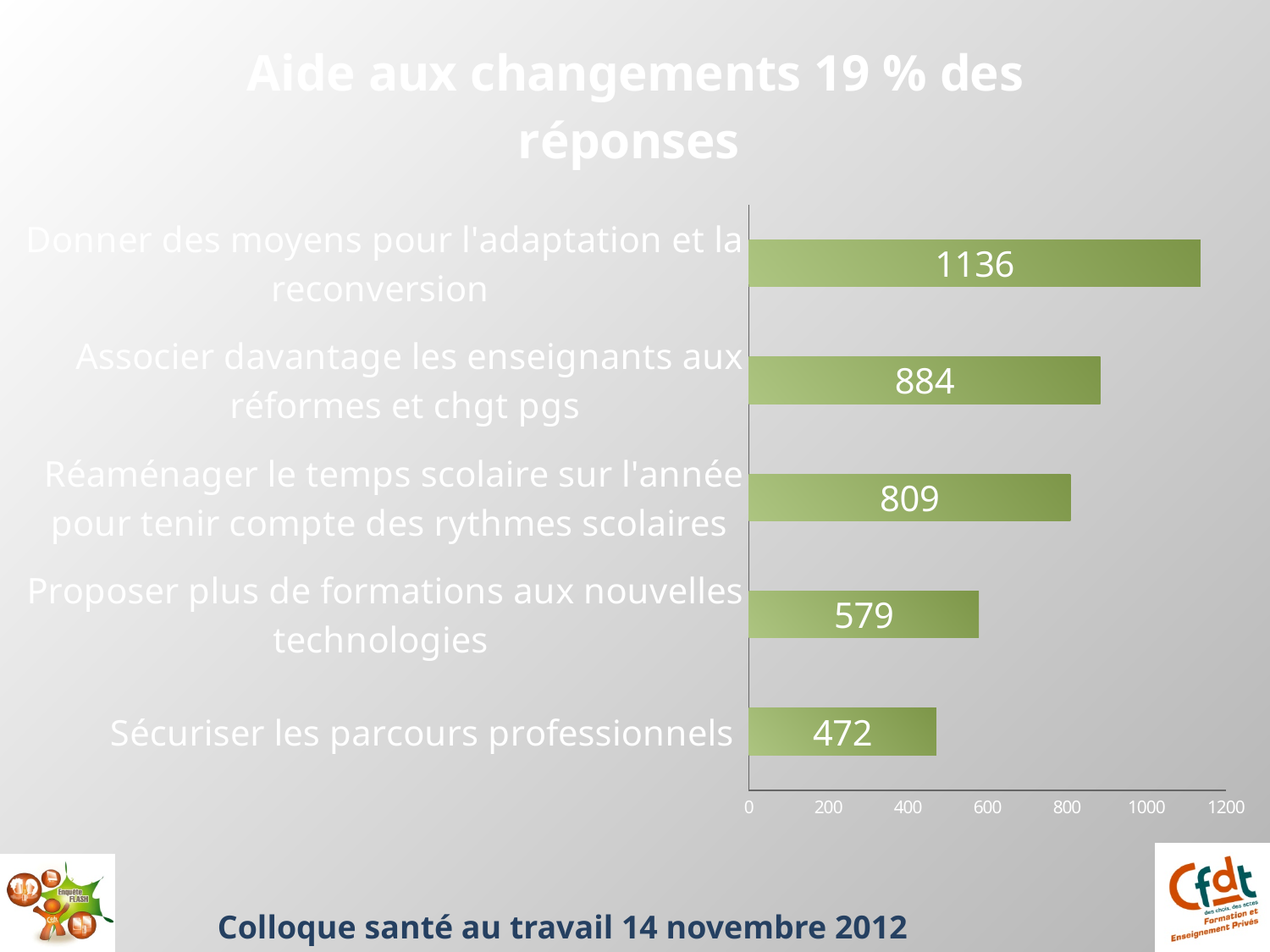
What is the value for "Proposer plus de formations aux nouvelles technologies"? 579 What is the value for "Associer davantage les enseignants aux réformes et chgt pgs"? 884 Which category has the lowest value? Sécuriser les parcours professionnels How many categories are shown in the chart? 5 Which category has the highest value? Donner des moyens pour l'adaptation et la reconversion What is the title of the chart? Aide aux changements 19 % des réponses Is the value for "Réaménager le temps scolaire sur l'année pour tenir compte des rythmes scolaires" greater or less than 1000? less Which is larger: the value for "Proposer plus de formations aux nouvelles technologies" or for "Sécuriser les parcours professionnels"? Proposer plus de formations aux nouvelles technologies What is the difference between the values for "Associer davantage les enseignants aux réformes et chgt pgs" and "Réaménager le temps scolaire sur l'année pour tenir compte des rythmes scolaires"? 75 What is the value for "Sécuriser les parcours professionnels"? 472 What kind of chart is shown on the slide? bar chart What is the value for "Donner des moyens pour l'adaptation et la reconversion"? 1136